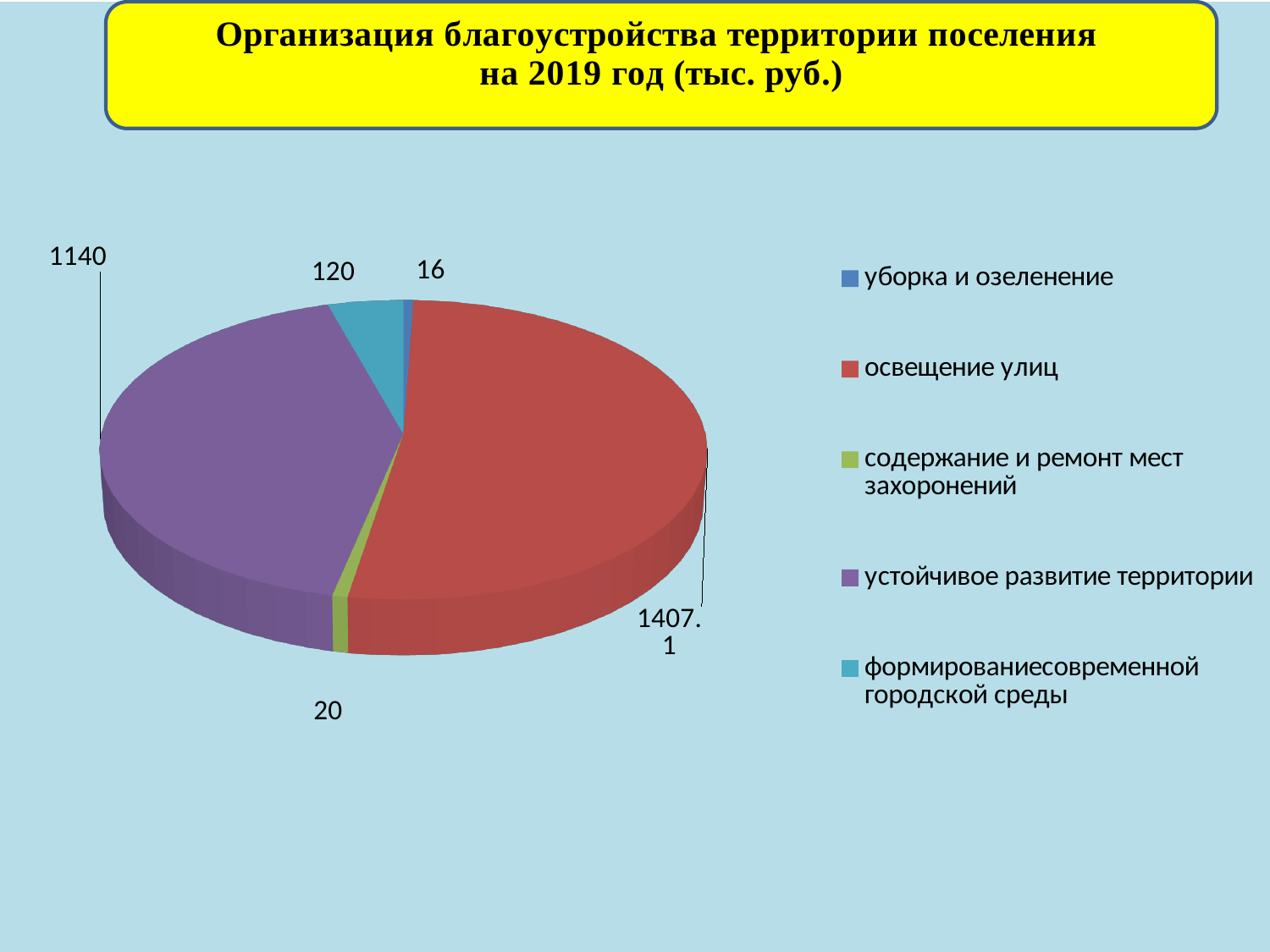
What is the value for освещение улиц? 1407.1 What is the value for формирование современной городской среды? 120 What is the value for содержание и ремонт мест захоронений? 20 What is the value for уборка и озеленение? 16 Which is larger, the value for формирование современной городской среды or the value for содержание и ремонт мест захоронений? формирование современной городской среды Which category has the smallest value? уборка и озеленение Which category has the largest value? освещение улиц How many categories does the pie chart have? 5 What kind of chart is shown on the slide? pie chart What is the total of all the values shown in the pie chart? 2703.1 What is the value for устойчивое развитие территории? 1140 What is the difference between the values for освещение улиц and устойчивое развитие территории? 267.1